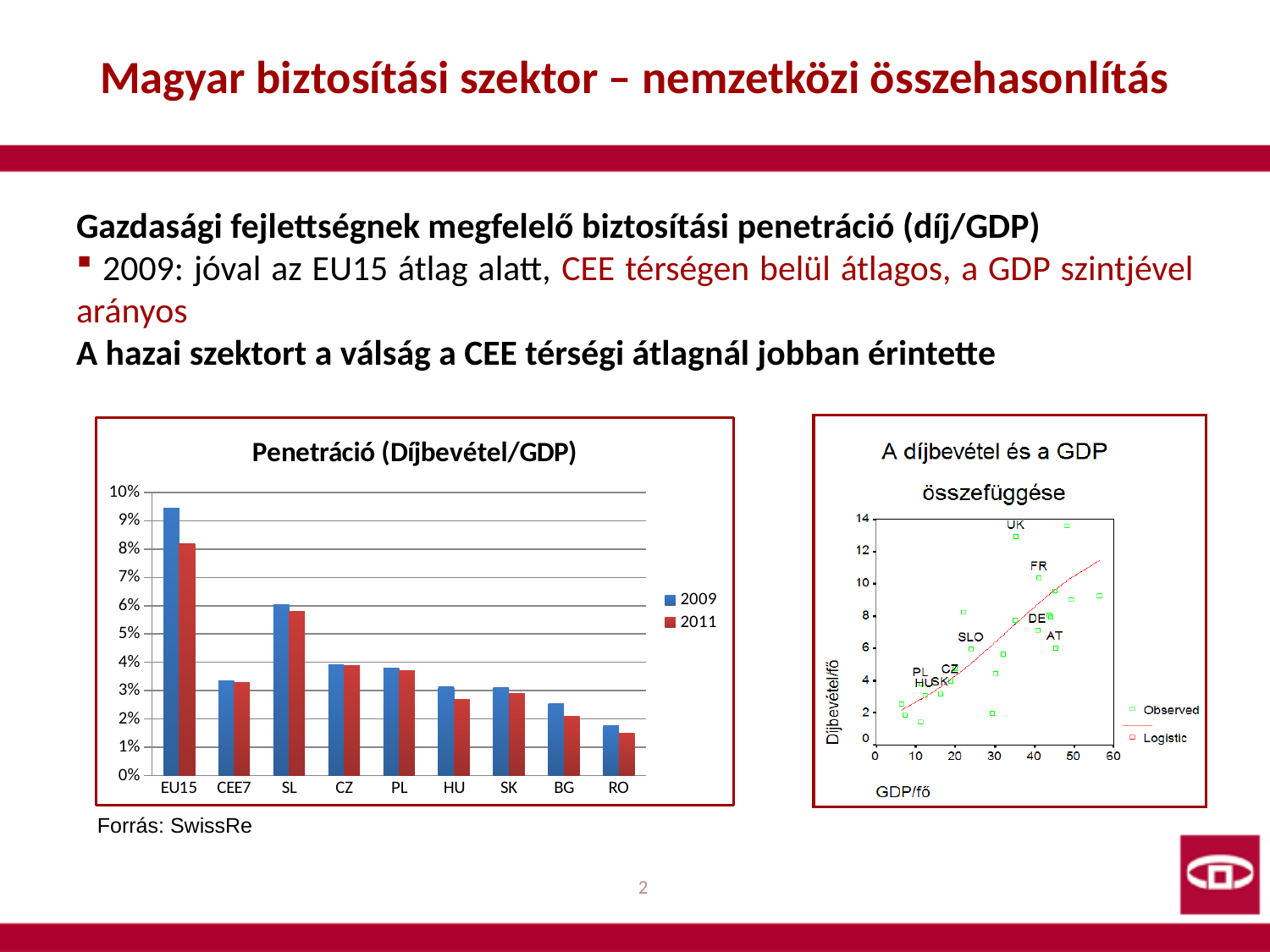
In the 'Penetráció (Díjbevétel/GDP)' chart, do the 2011 values generally rise or fall from EU15 on the left to RO on the right? fall How many series does the legend of the 'Penetráció (Díjbevétel/GDP)' chart list? 2 How many series does the legend of the 'A díjbevétel és a GDP összefüggése' chart list? 2 In the 'Penetráció (Díjbevétel/GDP)' chart, which category has the highest 2009 value? EU15 In the 'Penetráció (Díjbevétel/GDP)' chart, which category has the lowest 2011 value? RO In the 'Penetráció (Díjbevétel/GDP)' chart, which is larger for EU15: the 2009 value or the 2011 value? 2009 In the 'Penetráció (Díjbevétel/GDP)' chart, which is larger: the 2009 value for SL or the 2009 value for CZ? SL What are the two legend entries of the 'Penetráció (Díjbevétel/GDP)' chart? 2009 and 2011 How many categories are shown on the x axis of the 'Penetráció (Díjbevétel/GDP)' chart? 9 In the 'Penetráció (Díjbevétel/GDP)' chart, is the 2009 value for EU15 greater or less than 8%? greater In the 'Penetráció (Díjbevétel/GDP)' chart, is the 2011 value for HU greater or less than 3%? less What kind of chart is the 'Penetráció (Díjbevétel/GDP)' chart? bar chart